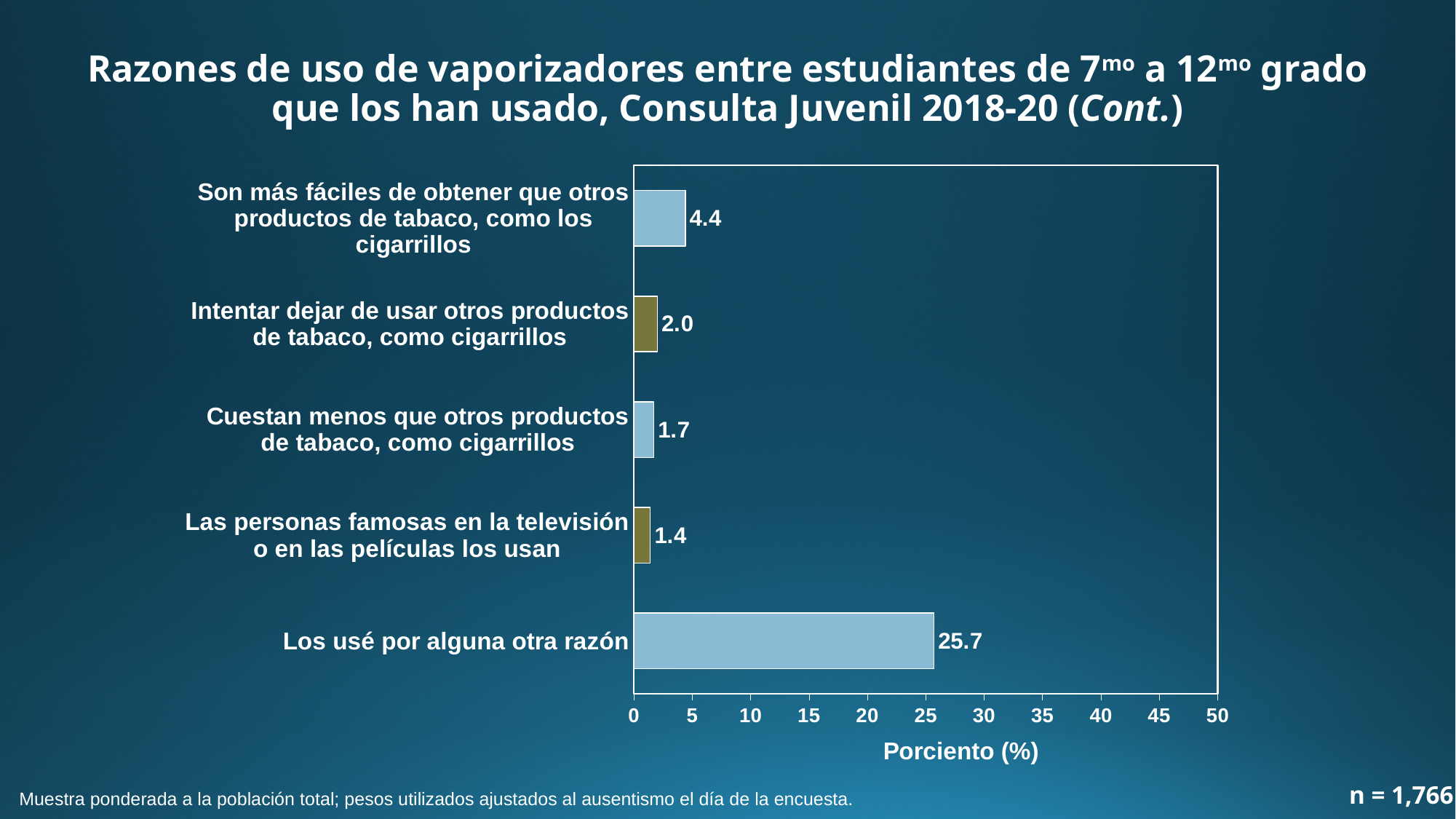
Is the value for "Los usé por alguna otra razón" greater or less than 20? greater What is the value for "Los usé por alguna otra razón"? 25.7 Which category has the highest value? Los usé por alguna otra razón What is the difference between the values for "Los usé por alguna otra razón" and "Son más fáciles de obtener que otros productos de tabaco, como los cigarrillos"? 21.3 Which is larger: the value for "Intentar dejar de usar otros productos de tabaco, como cigarrillos" or for "Cuestan menos que otros productos de tabaco, como cigarrillos"? Intentar dejar de usar otros productos de tabaco, como cigarrillos What is the label of the horizontal axis? Porciento (%) What kind of chart is shown on the slide? bar chart How many categories are shown in the chart? 5 What is the value for "Intentar dejar de usar otros productos de tabaco, como cigarrillos"? 2.0 Which category has the lowest value? Las personas famosas en la televisión o en las películas los usan What is the value for "Son más fáciles de obtener que otros productos de tabaco, como los cigarrillos"? 4.4 What is the value for "Las personas famosas en la televisión o en las películas los usan"? 1.4